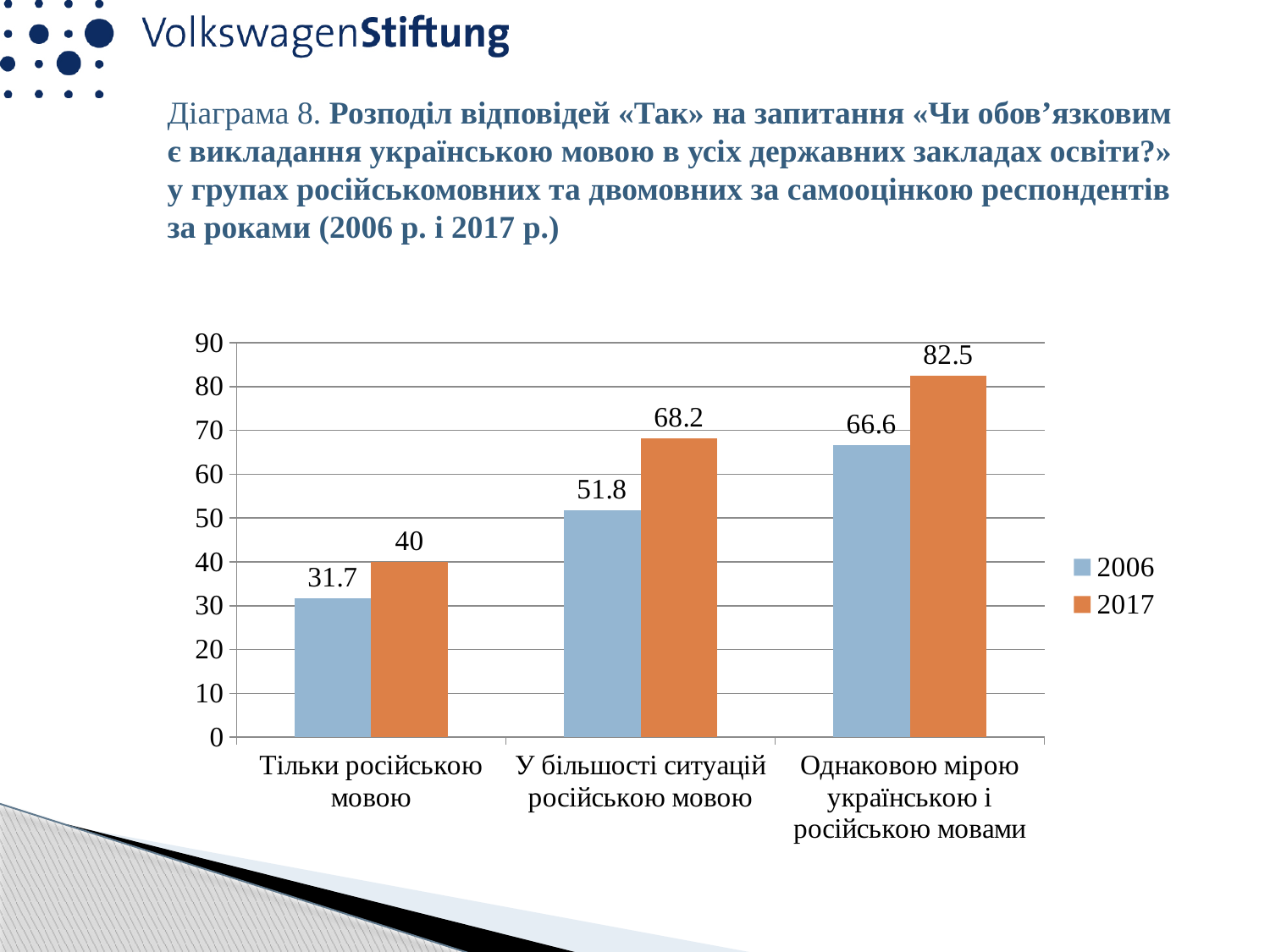
How many series does the legend list? 2 What kind of chart is shown on the slide? Bar chart What is the 2006 value for «Тільки російською мовою»? 31.7 Do the 2006 values rise or fall from left to right across the categories? Rise Which category has the lowest 2006 value? Тільки російською мовою How many categories are shown on the x axis? 3 Which category has the highest 2017 value? Однаковою мірою українською і російською мовами What is the difference between the 2017 and 2006 values for «Тільки російською мовою»? 8.3 What is the difference between the 2017 and 2006 values for «Однаковою мірою українською і російською мовами»? 15.9 Which is larger: the 2006 value for «Однаковою мірою українською і російською мовами» or the 2017 value for «У більшості ситуацій російською мовою»? 2017 value for «У більшості ситуацій російською мовою» What is the 2017 value for «Однаковою мірою українською і російською мовами»? 82.5 What is the 2017 value for «У більшості ситуацій російською мовою»? 68.2